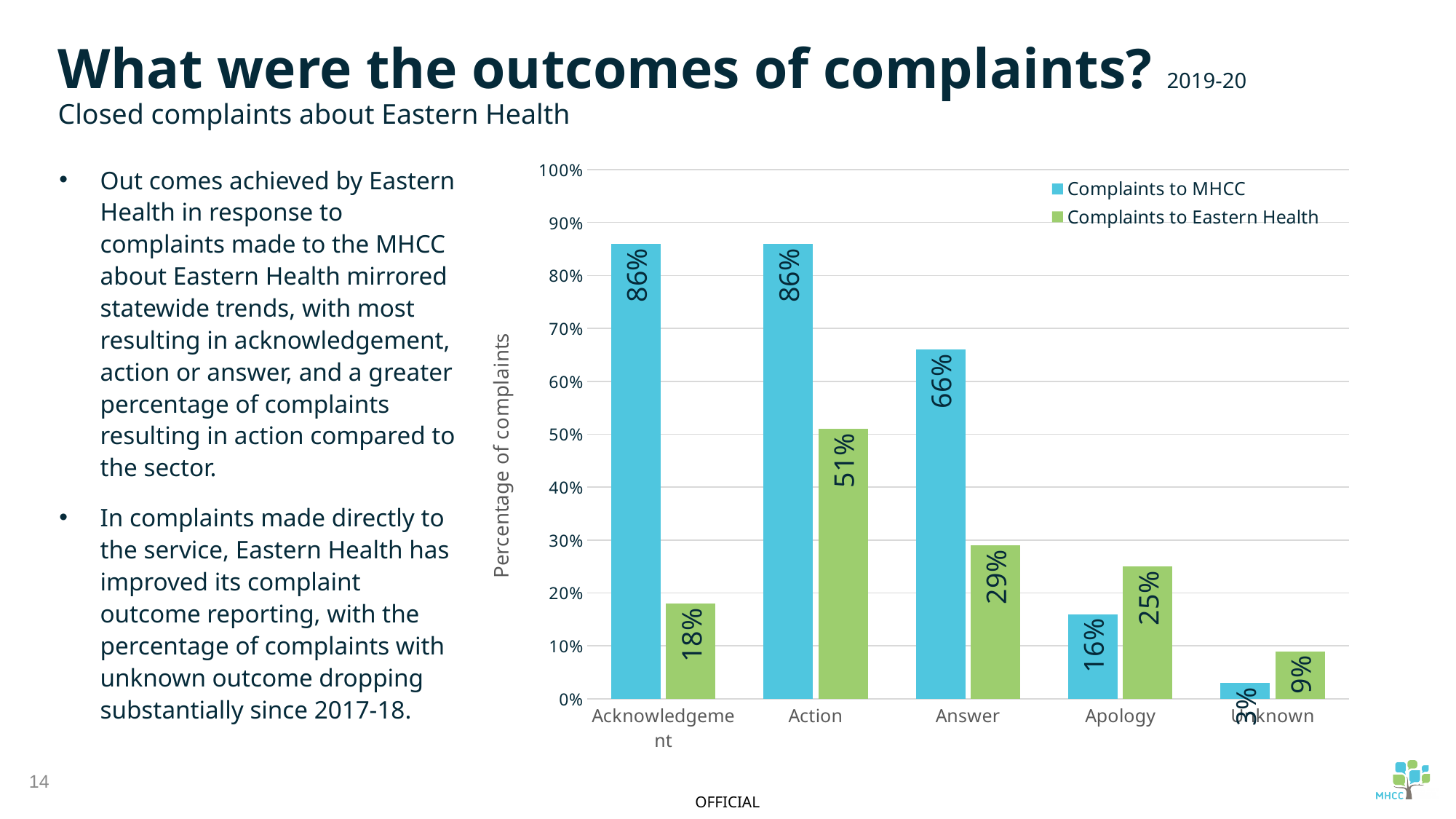
Which outcome has the lowest value for Complaints to Eastern Health? Unknown How many outcome categories are shown on the x axis? 5 What is the difference between the Complaints to MHCC and Complaints to Eastern Health values for Acknowledgement? 68% For Apology, which series has the larger value: Complaints to MHCC or Complaints to Eastern Health? Complaints to Eastern Health What is the value for Acknowledgement in the Complaints to Eastern Health series? 18% What percentage of complaints to Eastern Health resulted in Action? 51% What is the value for Apology in the Complaints to Eastern Health series? 25% What percentage of complaints to MHCC about Eastern Health resulted in an Answer? 66% What type of chart is shown on the slide? Bar chart Is the value for Unknown in the Complaints to MHCC series greater or less than 10%? less How many series does the legend list? 2 Which outcome has the highest value for Complaints to Eastern Health? Action